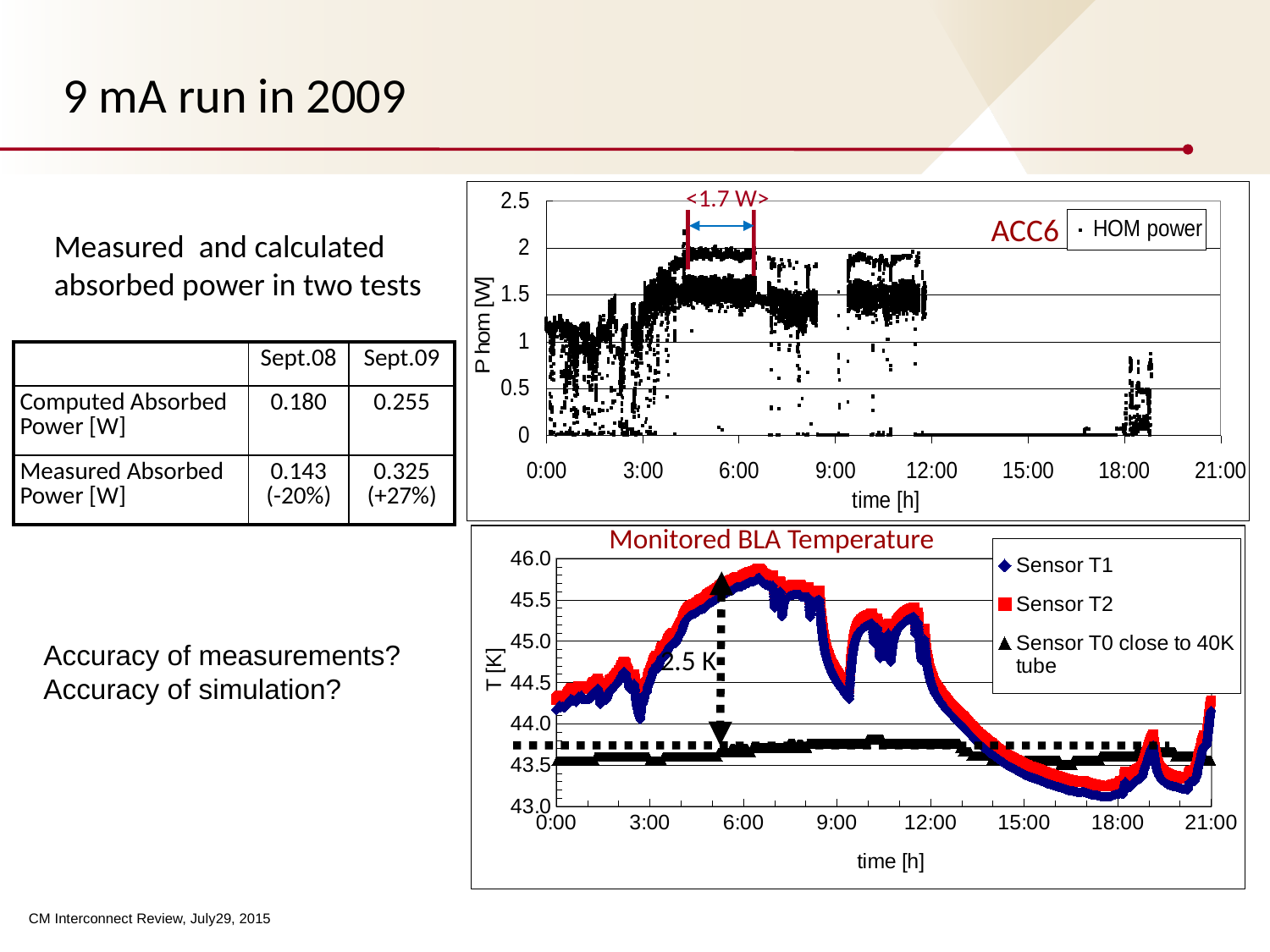
In the bottom chart (Monitored BLA Temperature), do the Sensor T2 values rise or fall between 12:00 and 15:00? fall How many series does the legend of the top chart (ACC6) list? 1 What is the y-axis label of the top chart (ACC6)? P hom [W] In the bottom chart (Monitored BLA Temperature), is the peak value of Sensor T2 around 6:00 greater or less than 45.5? greater How many series does the legend of the bottom chart (Monitored BLA Temperature) list? 3 What is the maximum value shown on the y-axis of the top chart (ACC6)? 2.5 In the top chart (ACC6), is the HOM power at 15:00 greater or less than 0.5? less In the bottom chart (Monitored BLA Temperature), do the Sensor T1 values rise or fall between 0:00 and 6:00? rise In the bottom chart (Monitored BLA Temperature), is the value of Sensor T0 close to 40K tube at 9:00 greater or less than 44.0? less What is the title of the bottom chart? Monitored BLA Temperature